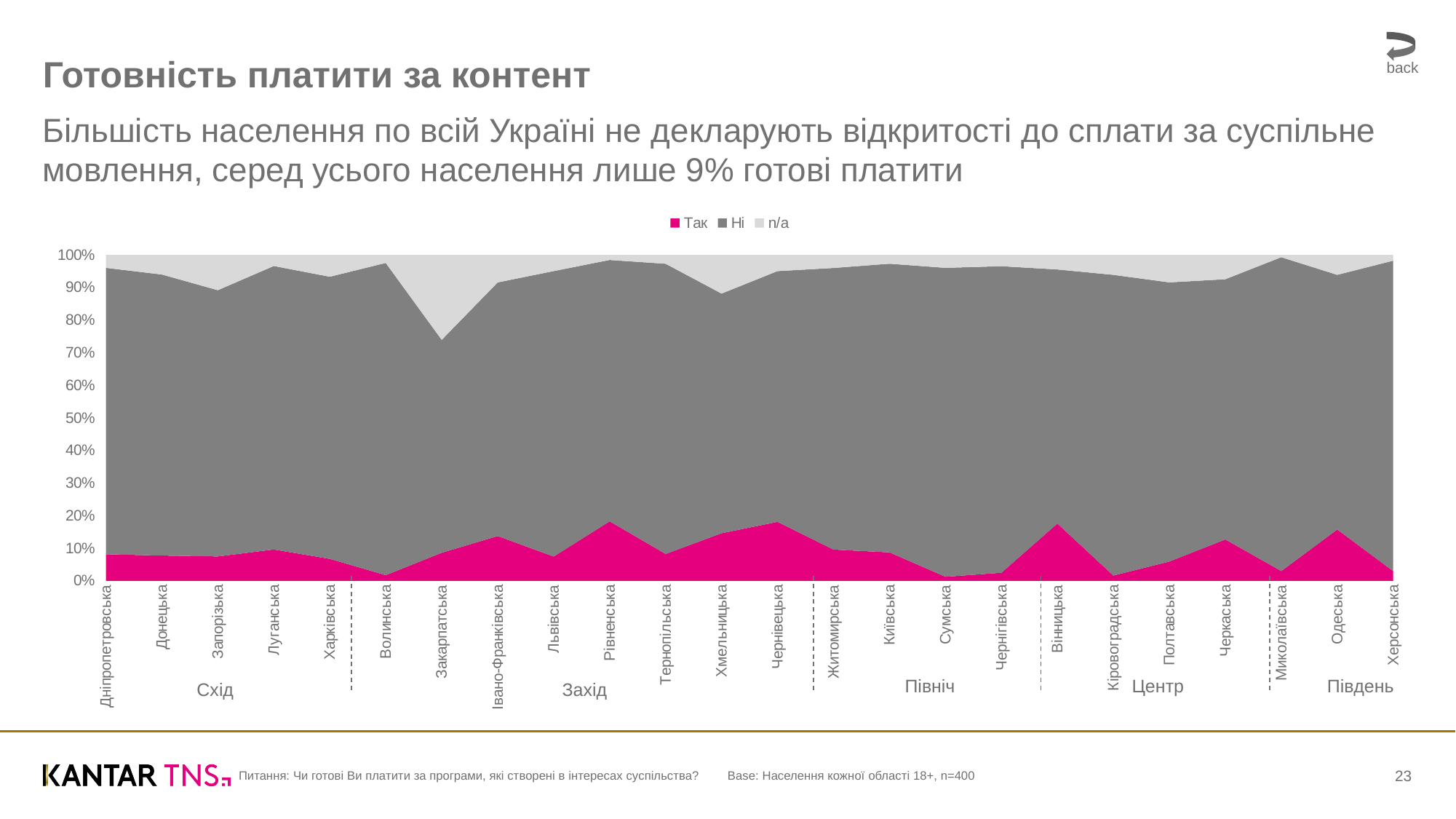
How many regional groups (Схід, Захід, etc.) are marked along the x axis? 5 What kind of chart is shown on the slide? Stacked area chart Which oblast has the largest n/a share? Закарпатська Which has the larger n/a value, Закарпатська or Рівненська? Закарпатська Which has the larger Так value, Вінницька or Кіровоградська? Вінницька Is the Так value for Волинська greater or less than 10%? less How many oblasts (categories) are plotted along the x axis? 24 How many series does the legend list? 3 Is the Так value for Сумська greater or less than 10%? less What are the series names listed in the legend? Так, Ні, n/a Is the Так value for Рівненська greater or less than 10%? greater